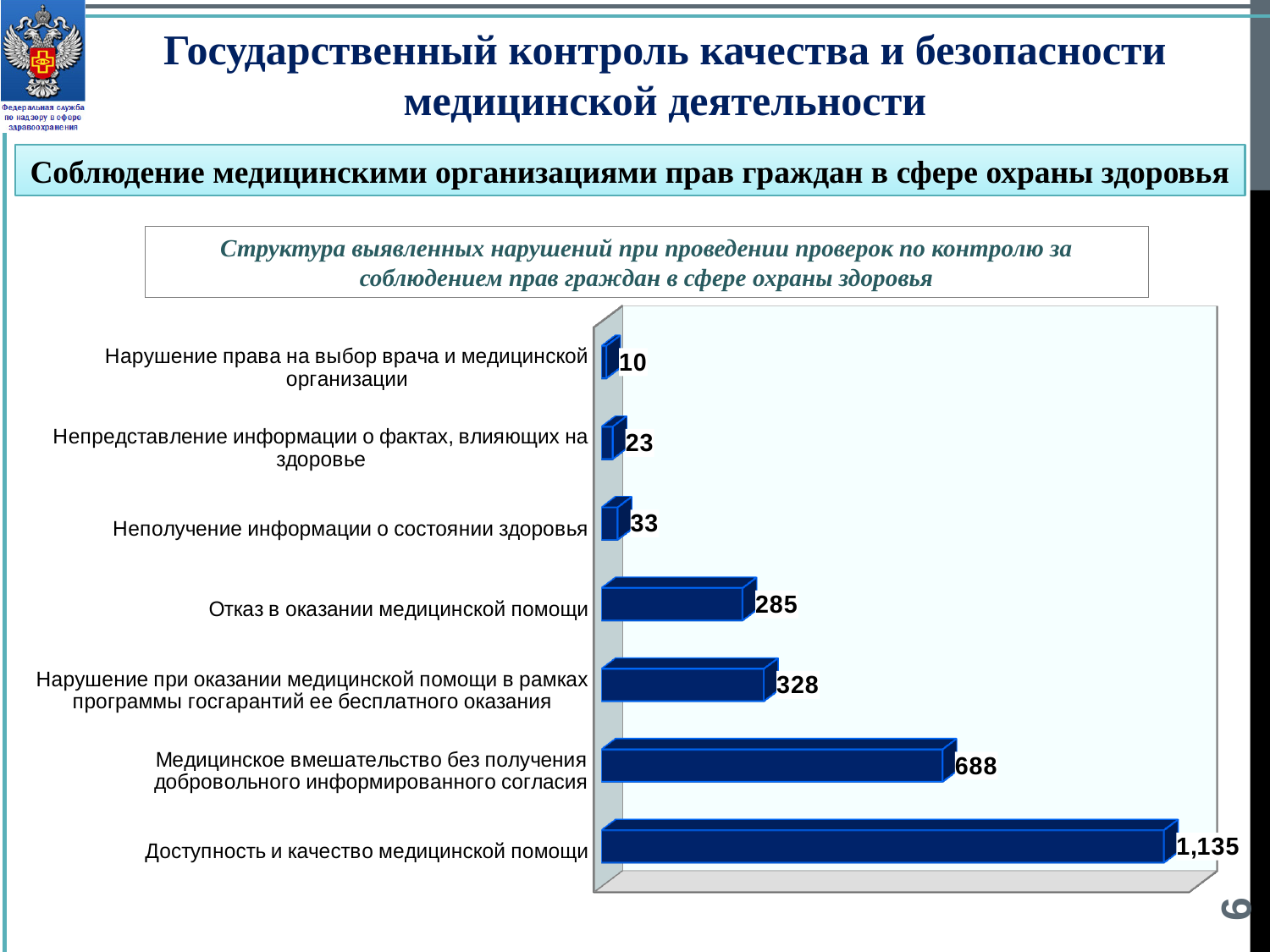
Which category has the lowest value? Нарушение права на выбор врача и медицинской организации Which category has the highest value? Доступность и качество медицинской помощи What is the value for «Доступность и качество медицинской помощи»? 1,135 What is the difference between the values for «Доступность и качество медицинской помощи» and «Медицинское вмешательство без получения добровольного информированного согласия»? 447 Which is larger: the value for «Непредставление информации о фактах, влияющих на здоровье» or the value for «Неполучение информации о состоянии здоровья»? Неполучение информации о состоянии здоровья How many categories are shown in the chart? 7 What is the difference between the values for «Нарушение при оказании медицинской помощи в рамках программы госгарантий ее бесплатного оказания» and «Отказ в оказании медицинской помощи»? 43 What is the value for «Отказ в оказании медицинской помощи»? 285 What is the value for «Неполучение информации о состоянии здоровья»? 33 What is the value for «Медицинское вмешательство без получения добровольного информированного согласия»? 688 What is the title of the chart? Структура выявленных нарушений при проведении проверок по контролю за соблюдением прав граждан в сфере охраны здоровья What kind of chart is shown on the slide? Bar chart